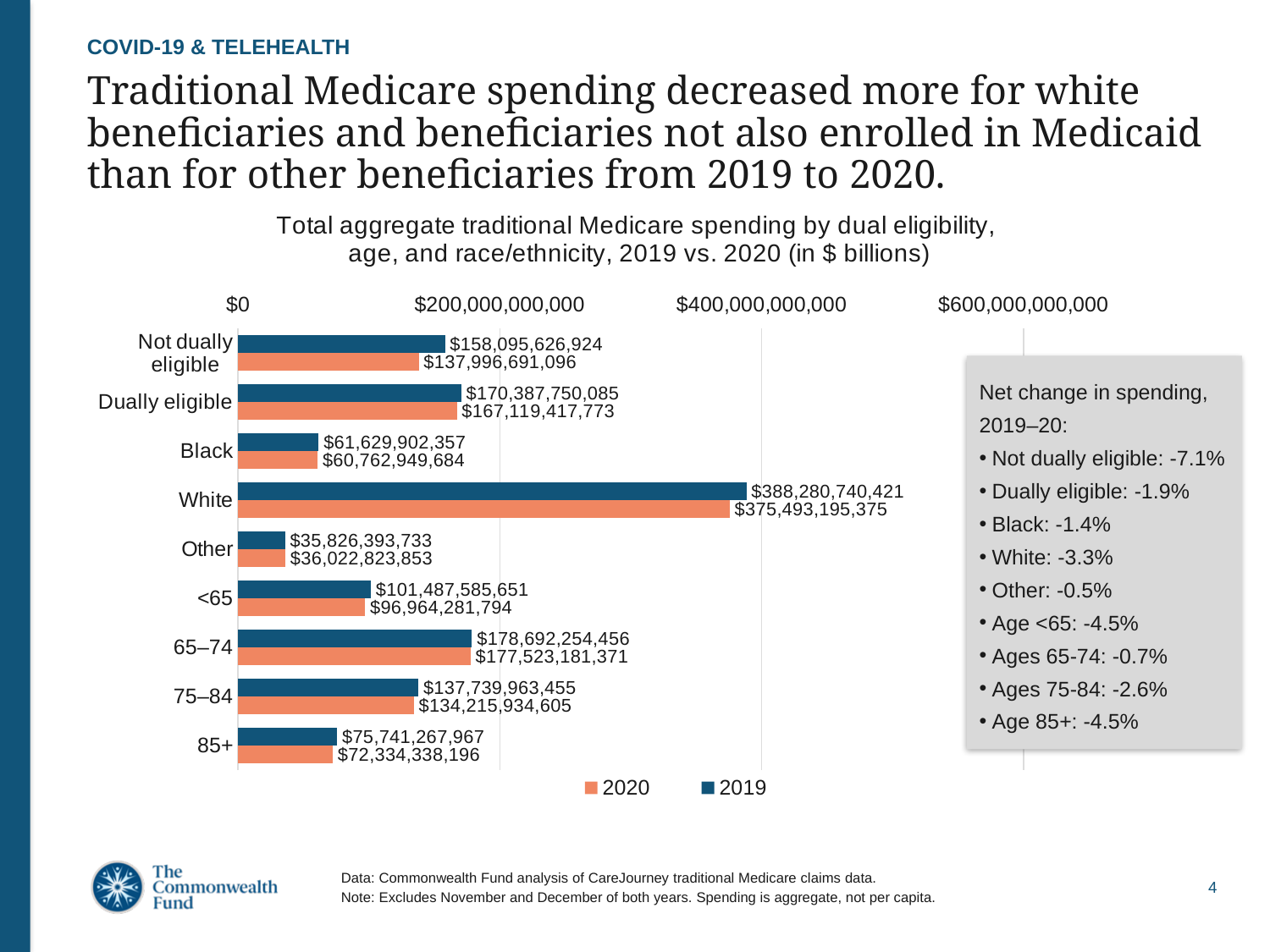
Is the 2019 spending value for Black beneficiaries greater or less than $200,000,000,000? less What was total traditional Medicare spending for dually eligible beneficiaries in 2020? $167,119,417,773 By how much did spending for not dually eligible beneficiaries decrease from 2019 to 2020? $20,098,935,828 How many categories are shown on the chart? 9 What is the difference between 2019 and 2020 spending for White beneficiaries? $12,787,545,046 What was total traditional Medicare spending for beneficiaries aged 85+ in 2020? $72,334,338,196 What was total traditional Medicare spending for White beneficiaries in 2019? $388,280,740,421 Which category had the highest traditional Medicare spending in 2019? White For the Other race/ethnicity category, was spending higher in 2019 or 2020? 2020 How many series does the legend list? 2 What type of chart is shown on the slide? Bar chart Which category had the lowest traditional Medicare spending in 2020? Other